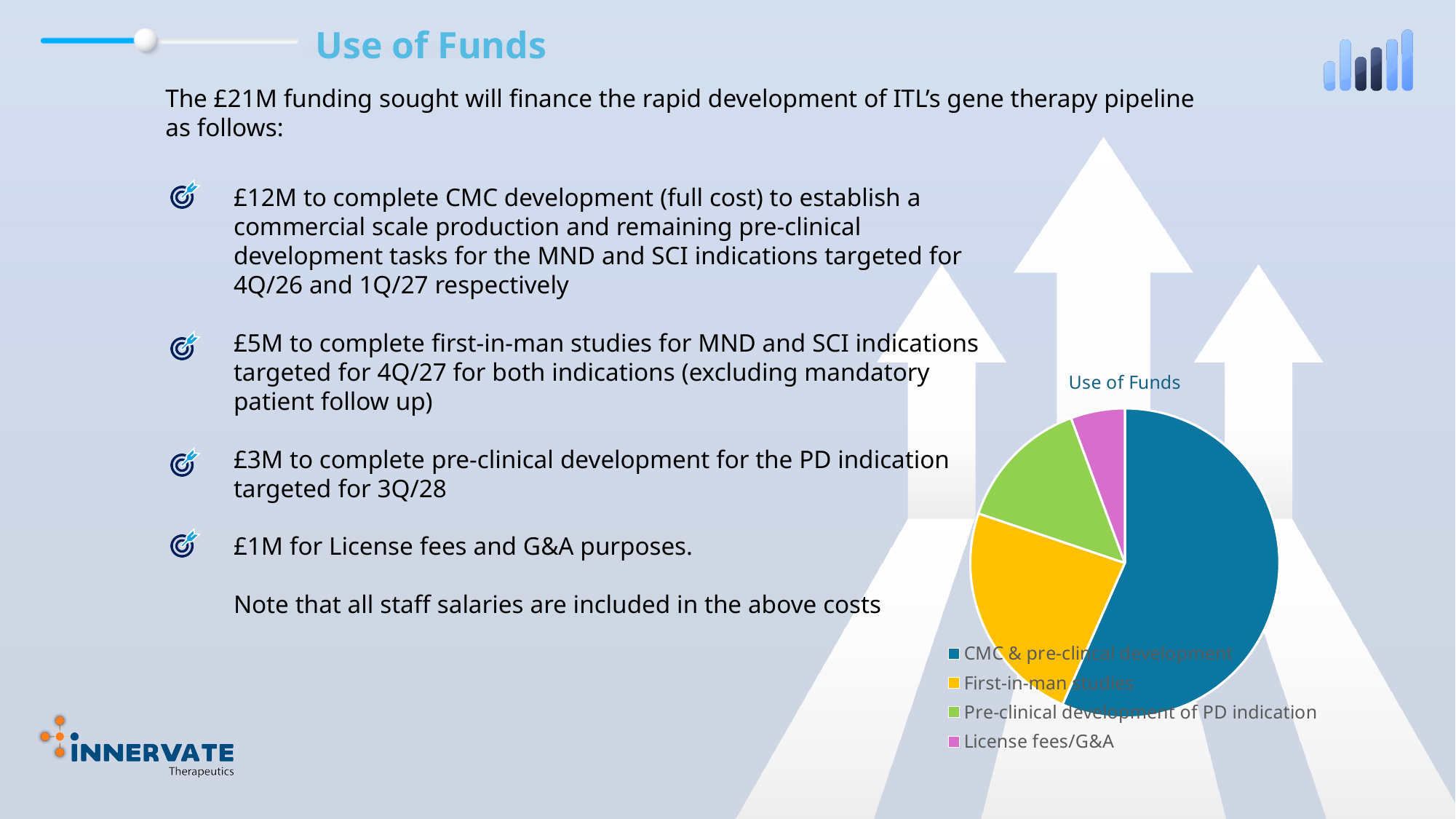
Which slice is larger: CMC & pre-clinical development or First-in-man studies? CMC & pre-clinical development Which category has the smallest slice of the pie chart? License fees/G&A How many slices does the pie chart have? 4 How many entries does the chart legend list? 4 Which slice is larger: First-in-man studies or Pre-clinical development of PD indication? First-in-man studies Which category has the largest slice of the pie chart? CMC & pre-clinical development Which slice is larger: Pre-clinical development of PD indication or License fees/G&A? Pre-clinical development of PD indication What kind of chart is shown on the slide? pie chart What is the title of the chart? Use of Funds What colour is the slice for First-in-man studies? yellow